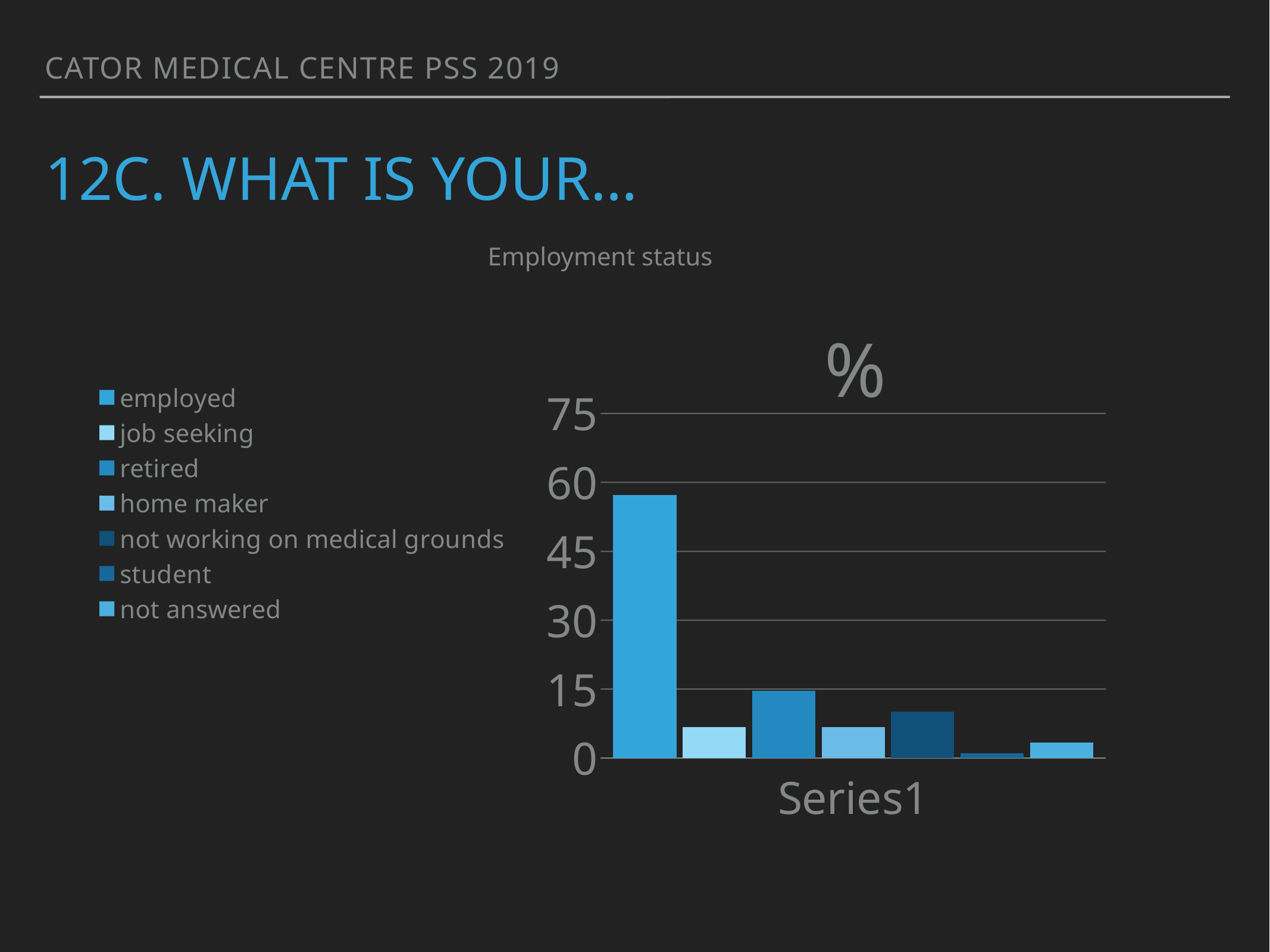
How many series does the legend list? 7 Which is larger, the value for not working on medical grounds or the value for not answered? not working on medical grounds Is the value for employed greater or less than 60? less What kind of chart is shown on the slide? bar chart What is the title of the chart? % Which employment status has the lowest bar? student Which is larger, the value for retired or the value for job seeking? retired Is the value for employed greater or less than 45? greater Is the value for retired greater or less than 30? less Which employment status has the highest bar? employed